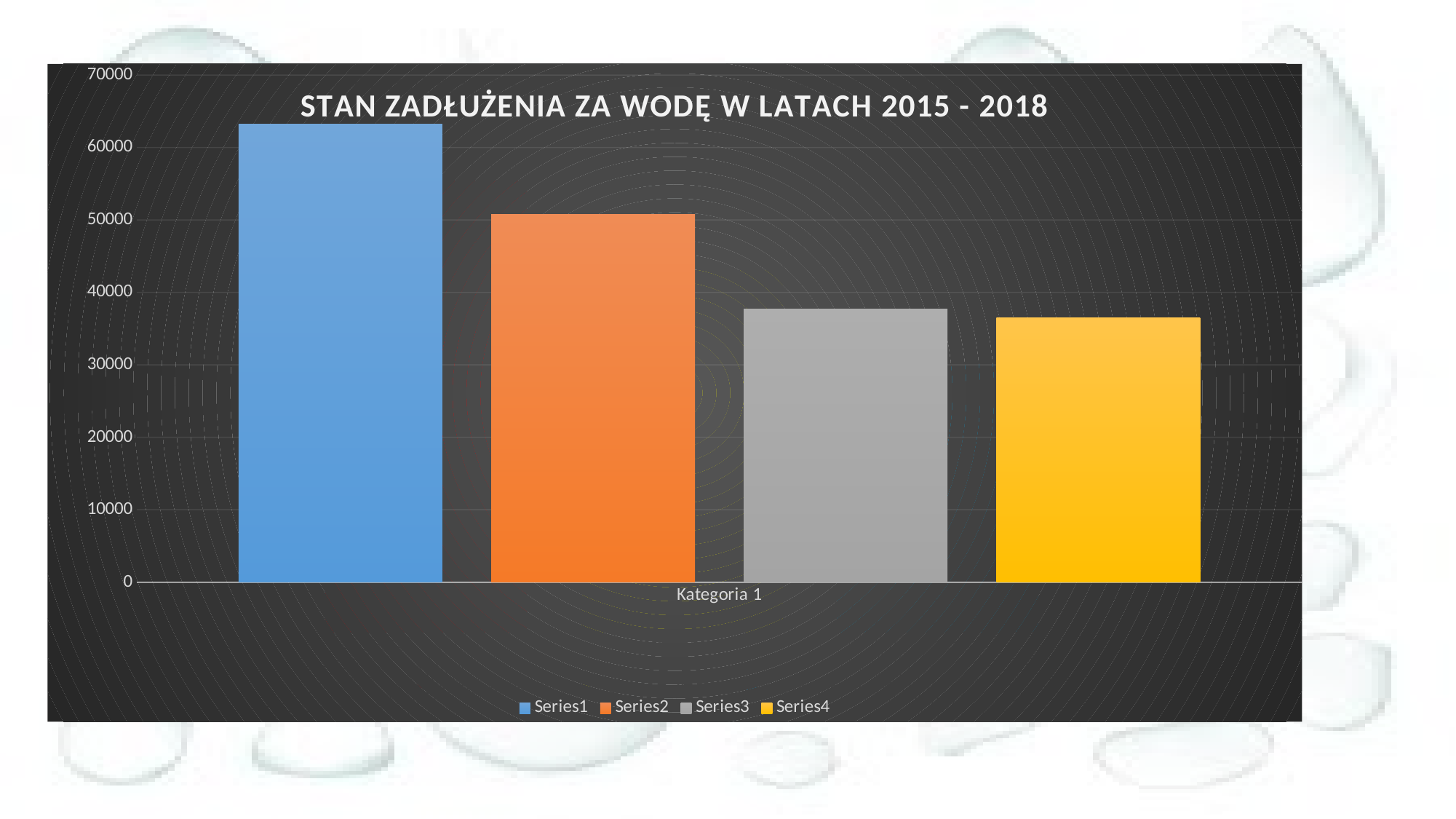
Is the value for Series4 greater or less than 30000? greater Which series has the highest value? Series1 Is the value for Series1 greater or less than 60000? greater Is the value for Series3 greater or less than 40000? less What kind of chart is shown on the slide? bar chart How many categories are shown on the x axis? 1 What is the label of the category on the x axis? Kategoria 1 Which is larger, the value for Series1 or the value for Series2? Series1 How many series does the legend list? 4 What is the title of the chart? STAN ZADŁUŻENIA ZA WODĘ W LATACH 2015 - 2018 Which is larger, the value for Series2 or the value for Series3? Series2